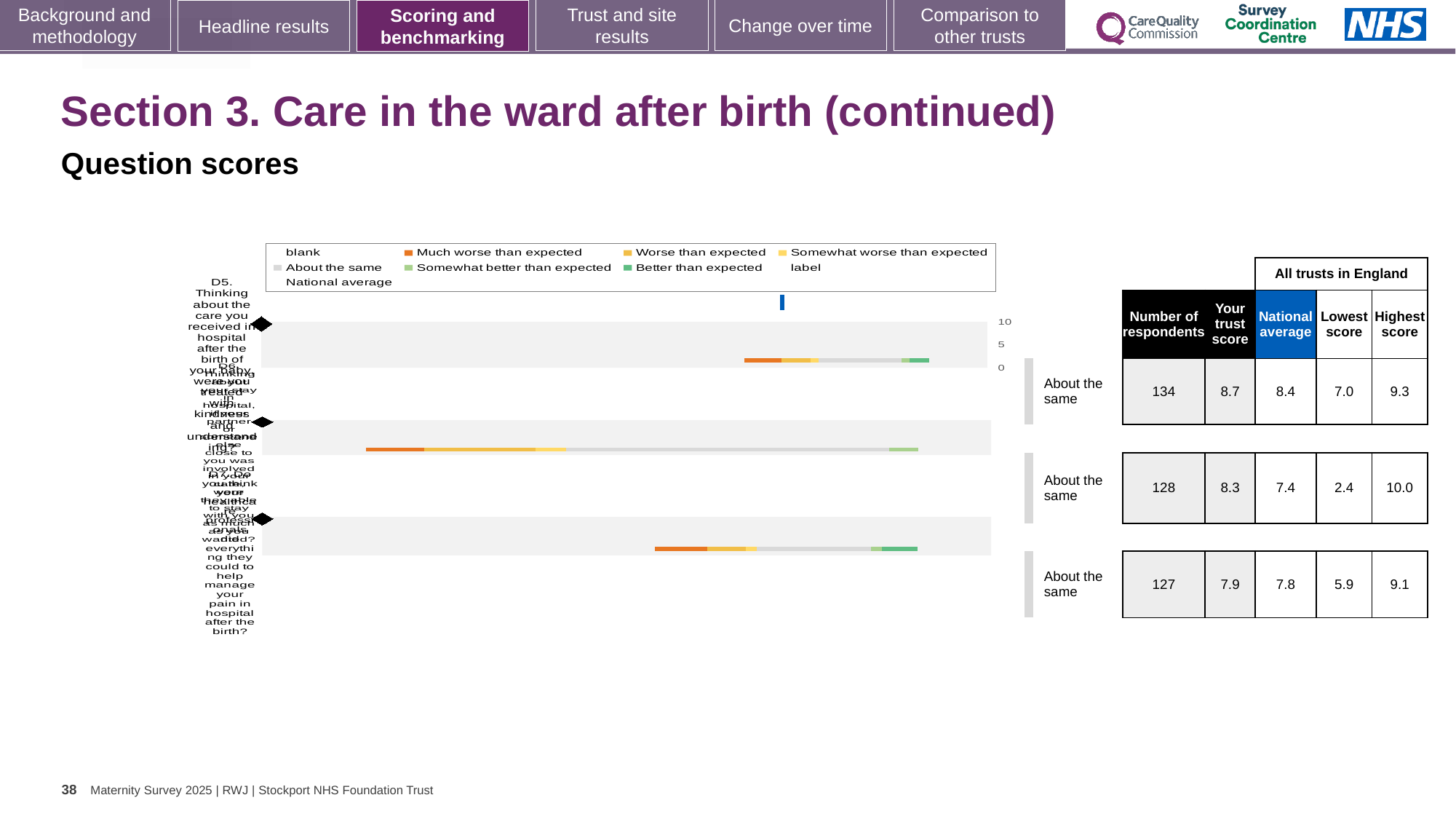
What kind of chart is shown on the slide? bar chart What colour does the legend use for 'Better than expected'? green In the table beside the chart, what is the number of respondents for the top row? 134 In the table beside the chart, what is the national average for the second row? 7.4 In the table beside the chart, what is the difference between 'Your trust score' and the national average for the top row? 0.3 What colour does the legend use for 'Much worse than expected'? orange In the table beside the chart, what is the lowest score for the third row? 5.9 In the table beside the chart, for the second row, which is larger: 'Your trust score' or the national average? Your trust score How many entries does the chart's legend list? 9 In the table beside the chart, which row has the highest 'Highest score' value? the second row (10.0) In the table beside the chart, what is 'Your trust score' for the top row? 8.7 How many stacked bars (question rows) are plotted in the chart? 3